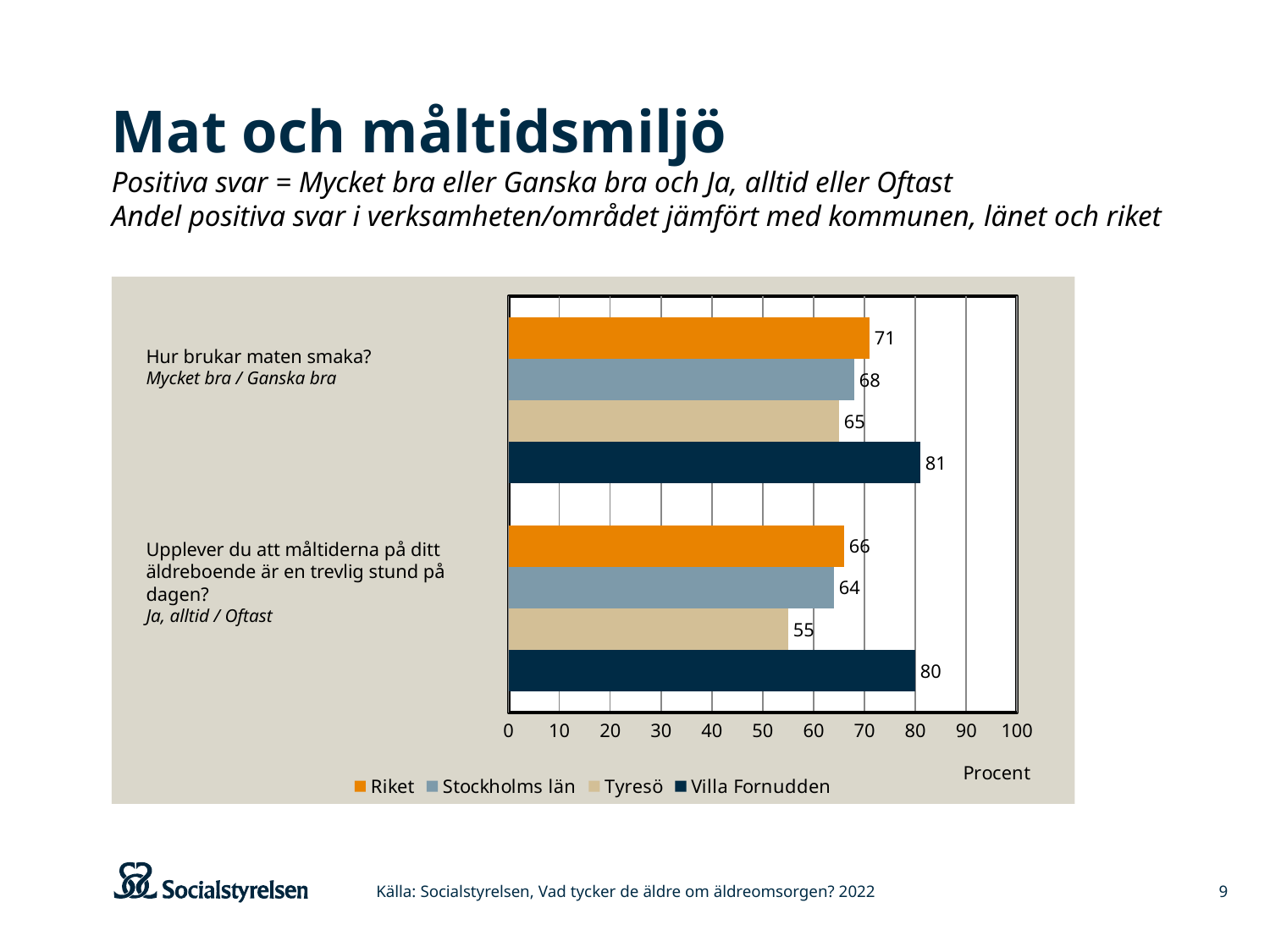
Which is larger on the question "Hur brukar maten smaka?": Riket or Tyresö? Riket What unit is shown on the x axis of the chart? Procent How many series does the legend list? 4 What is the value for Riket on the question "Hur brukar maten smaka?"? 71 What is the difference between Villa Fornudden and Tyresö on the question "Upplever du att måltiderna på ditt äldreboende är en trevlig stund på dagen?"? 25 Which series has the lowest value on the question "Upplever du att måltiderna på ditt äldreboende är en trevlig stund på dagen?"? Tyresö What is the value for Stockholms län on the question "Upplever du att måltiderna på ditt äldreboende är en trevlig stund på dagen?"? 64 Which series has the highest value on the question "Hur brukar maten smaka?"? Villa Fornudden What is the difference between Riket and Stockholms län on the question "Hur brukar maten smaka?"? 3 What is the value for Tyresö on the question "Upplever du att måltiderna på ditt äldreboende är en trevlig stund på dagen?"? 55 What is the value for Villa Fornudden on the question "Hur brukar maten smaka?"? 81 What kind of chart is shown on the slide? Bar chart